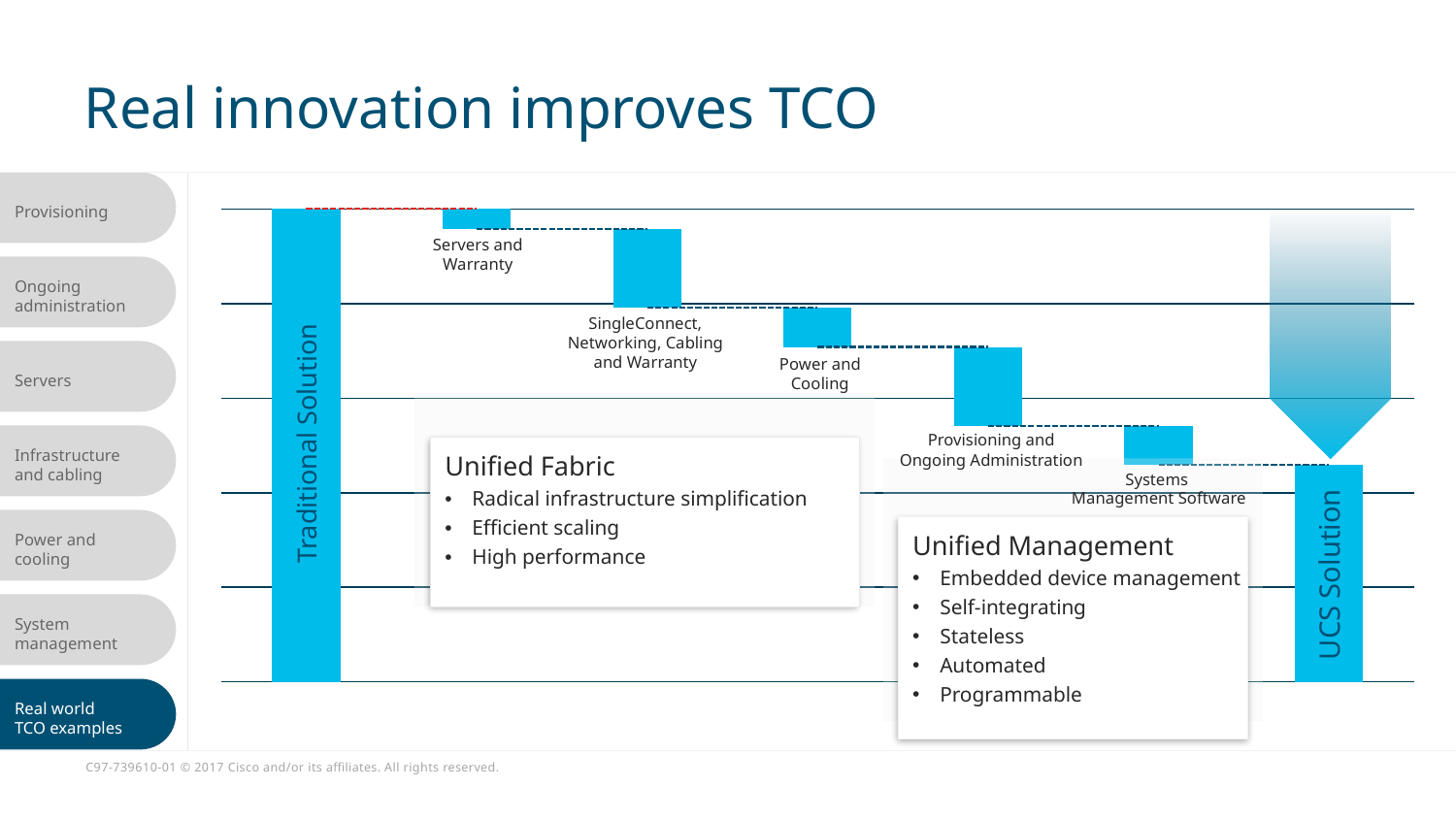
What is the label of the first step bar after Traditional Solution? Servers and Warranty Do the bar tops fall or rise moving from left to right across the chart? fall Which bar in the chart is the tallest? Traditional Solution Which step bar is taller, Power and Cooling or Provisioning and Ongoing Administration? Provisioning and Ongoing Administration Which bar is taller, Traditional Solution or UCS Solution? Traditional Solution What kind of chart is shown on the slide? bar chart (waterfall) Which step bar is taller, Servers and Warranty or SingleConnect, Networking, Cabling and Warranty? SingleConnect, Networking, Cabling and Warranty What is the label of the bar immediately to the left of the UCS Solution bar? Systems Management Software How many bars are plotted in the chart, including the Traditional Solution and UCS Solution bars? 7